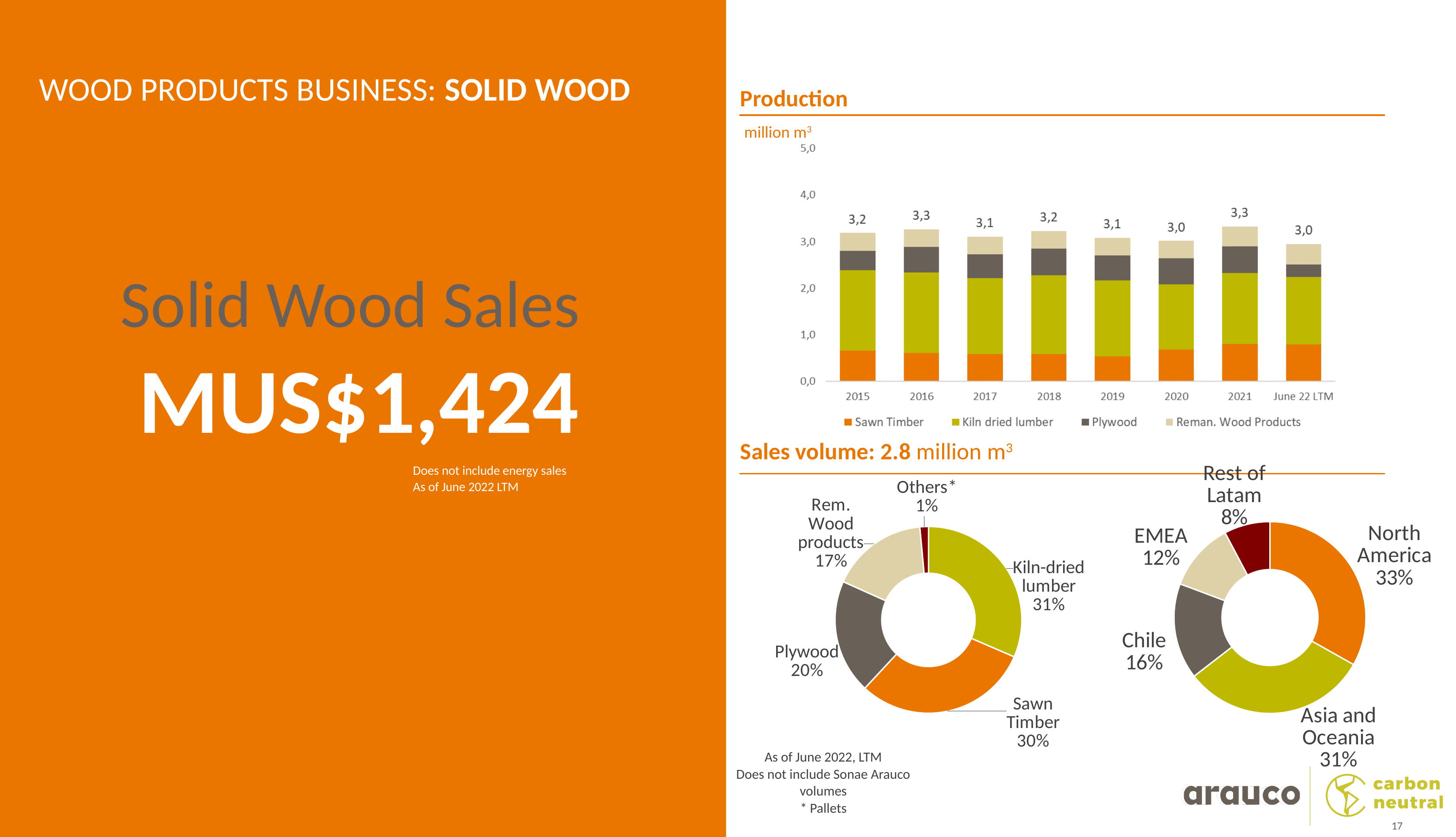
What kind of chart is the Production chart? stacked bar chart On the Production chart, how many periods are shown on the x axis? 8 On the Production chart, what is the total production value labelled for 2016? 3,3 On the Production chart, which total is larger, 2021 or 2020? 2021 On the Production chart, what is the difference between the total for 2016 and the total for 2017? 0,2 On the sales volume by product donut chart (left), what share does Plywood have? 20% On the Production chart, how many series does the legend list? 4 On the Production chart, is the Sawn Timber value for 2021 greater or less than 1,0? less On the sales volume by region donut chart (right), which region has the largest share? North America On the sales volume by region donut chart (right), what share does EMEA have? 12% On the sales volume by product donut chart (left), which category has the smallest share? Others On the Production chart, what is the total production value labelled for June 22 LTM? 3,0